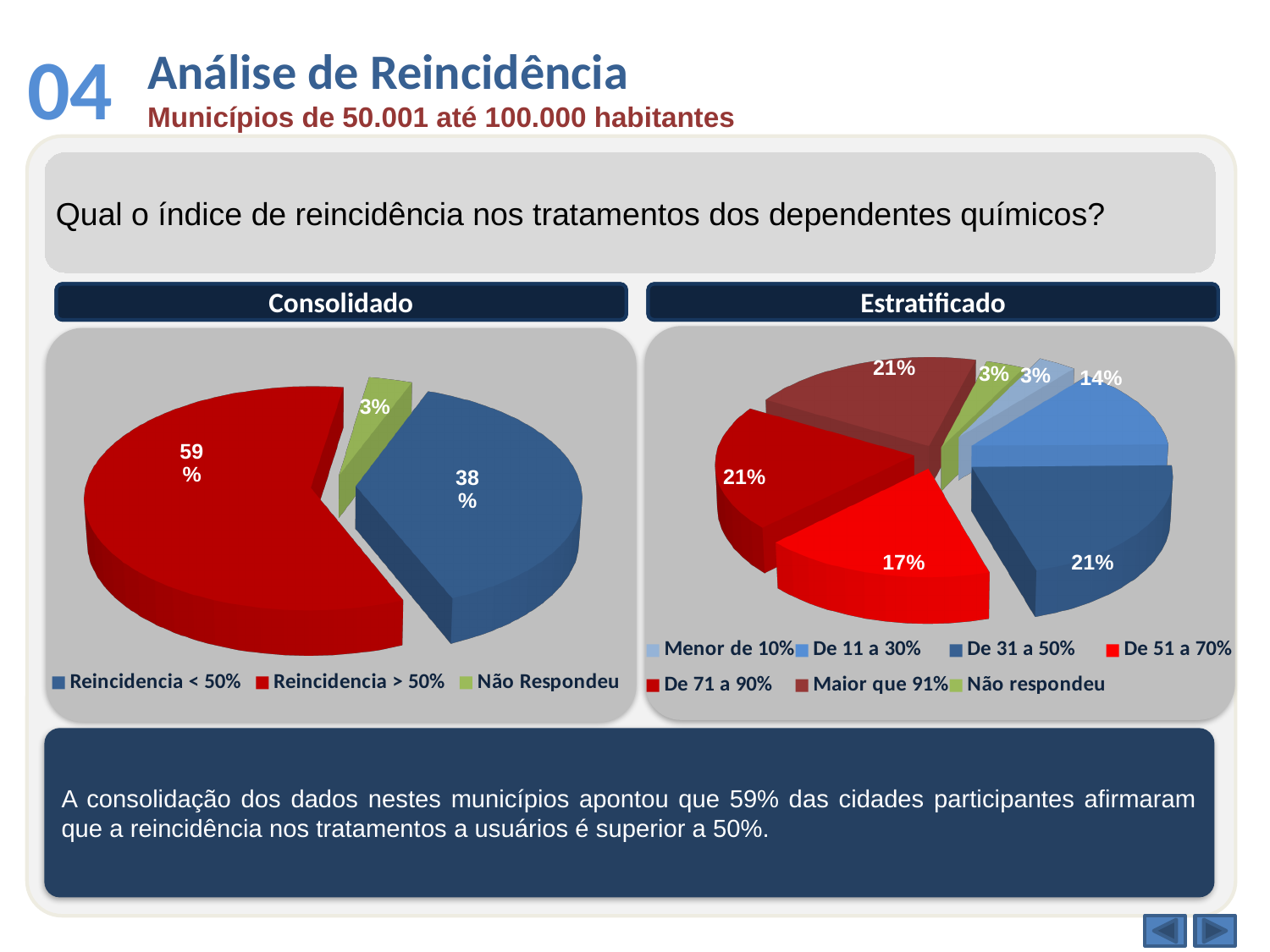
In the Estratificado chart, what is the value for De 51 a 70%? 17% In the Estratificado chart, which is larger, De 31 a 50% or De 51 a 70%? De 31 a 50% In the Consolidado chart, what is the difference between Reincidencia > 50% and Reincidencia < 50%? 21 percentage points In the Estratificado chart, what is the value for Maior que 91%? 21% In the Consolidado chart, how many categories does the legend list? 3 In the Consolidado chart, what is the value for Reincidencia < 50%? 38% In the Estratificado chart, what is the difference between De 71 a 90% and Menor de 10%? 18 percentage points In the Estratificado chart, how many categories does the legend list? 7 In the Consolidado chart, what is the value for Reincidencia > 50%? 59% In the Estratificado chart, what is the value for De 11 a 30%? 14% In the Consolidado chart, which category has the smallest slice? Não Respondeu What kind of chart is the Estratificado chart? Pie chart